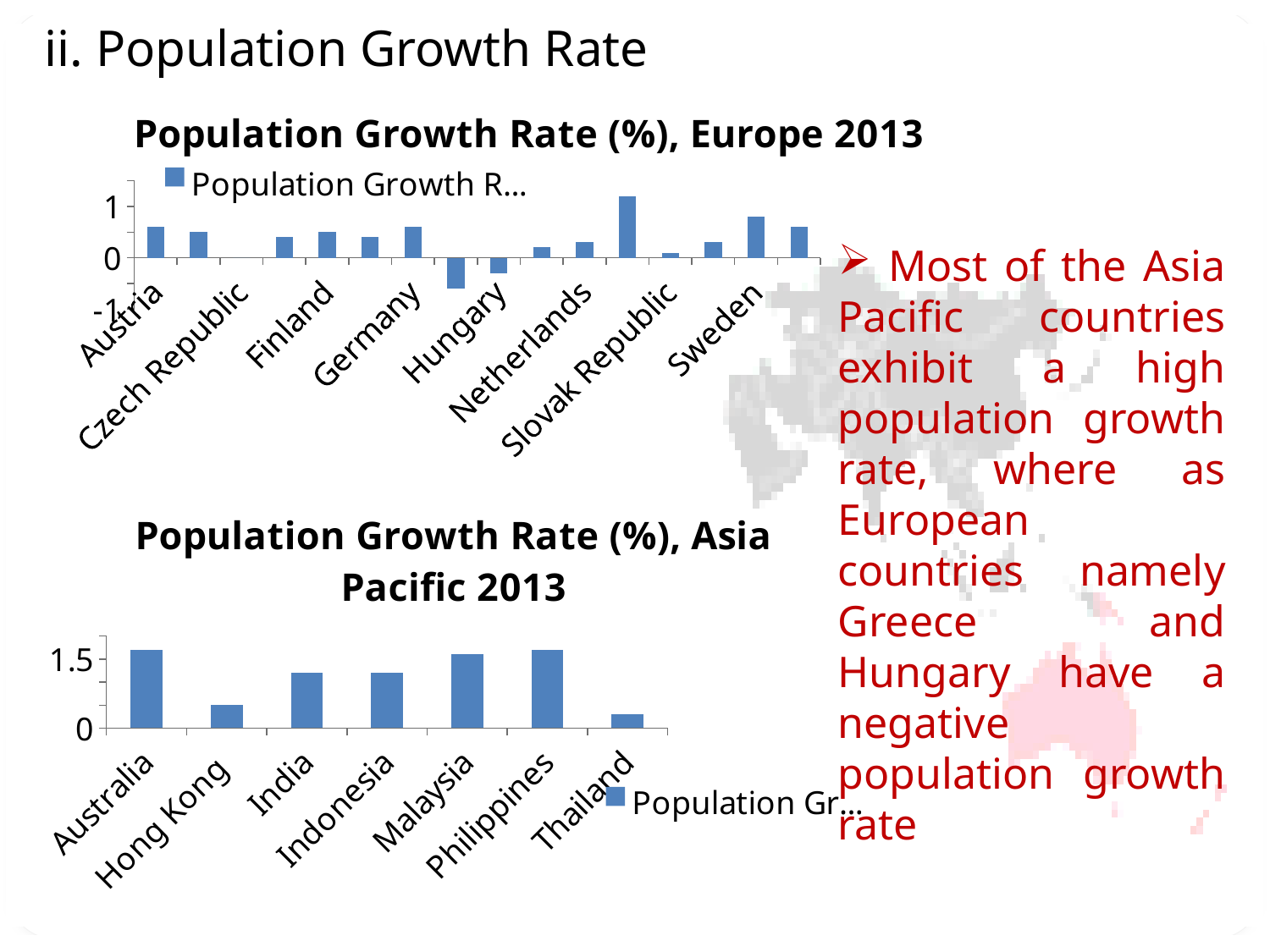
In the 'Population Growth Rate (%), Asia Pacific 2013' chart, which country has the lowest population growth rate? Thailand What type of chart is the 'Population Growth Rate (%), Asia Pacific 2013' chart? Bar chart In the 'Population Growth Rate (%), Europe 2013' chart, is the value for Sweden greater or less than 0? greater In the 'Population Growth Rate (%), Asia Pacific 2013' chart, which has the larger value, Malaysia or Thailand? Malaysia What is the title of the top chart on the slide? Population Growth Rate (%), Europe 2013 How many series does the legend of the 'Population Growth Rate (%), Europe 2013' chart list? 1 In the 'Population Growth Rate (%), Europe 2013' chart, is the value for Hungary greater or less than 0? less In the 'Population Growth Rate (%), Europe 2013' chart, which has the larger value, Austria or Hungary? Austria In the 'Population Growth Rate (%), Asia Pacific 2013' chart, is the value for Hong Kong greater or less than 1.5? less In the 'Population Growth Rate (%), Asia Pacific 2013' chart, which has the larger value, Australia or Hong Kong? Australia How many countries are shown on the 'Population Growth Rate (%), Asia Pacific 2013' chart? 7